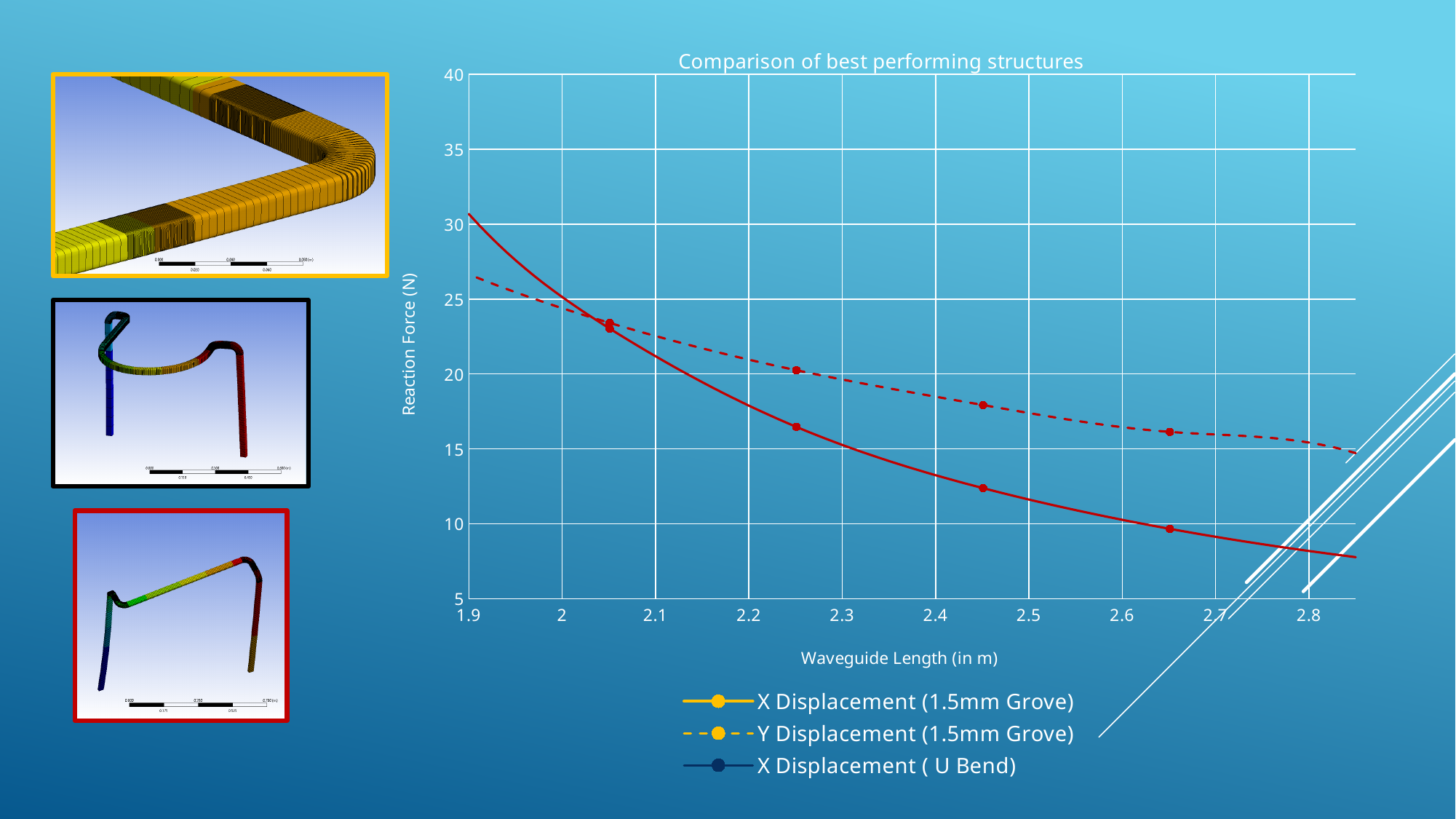
How many series does the chart's legend list? 3 Is the value of the dashed line at a waveguide length of about 2.65 m greater or less than 15? greater Is the value of the dashed line at a waveguide length of about 2.45 m greater or less than 20? less Do the values of the solid line rise or fall as waveguide length increases along the x axis? fall What is the label of the chart's y axis? Reaction Force (N) How many marked data points are plotted on the solid line? 4 What kind of chart is shown on the slide? line chart At a waveguide length of about 2.45 m, which line has the higher reaction force, the solid line or the dashed line? the dashed line Do the values of the dashed line rise or fall as waveguide length increases along the x axis? fall Is the value of the solid line at a waveguide length of about 2.45 m greater or less than 10? greater What is the title of the chart? Comparison of best performing structures